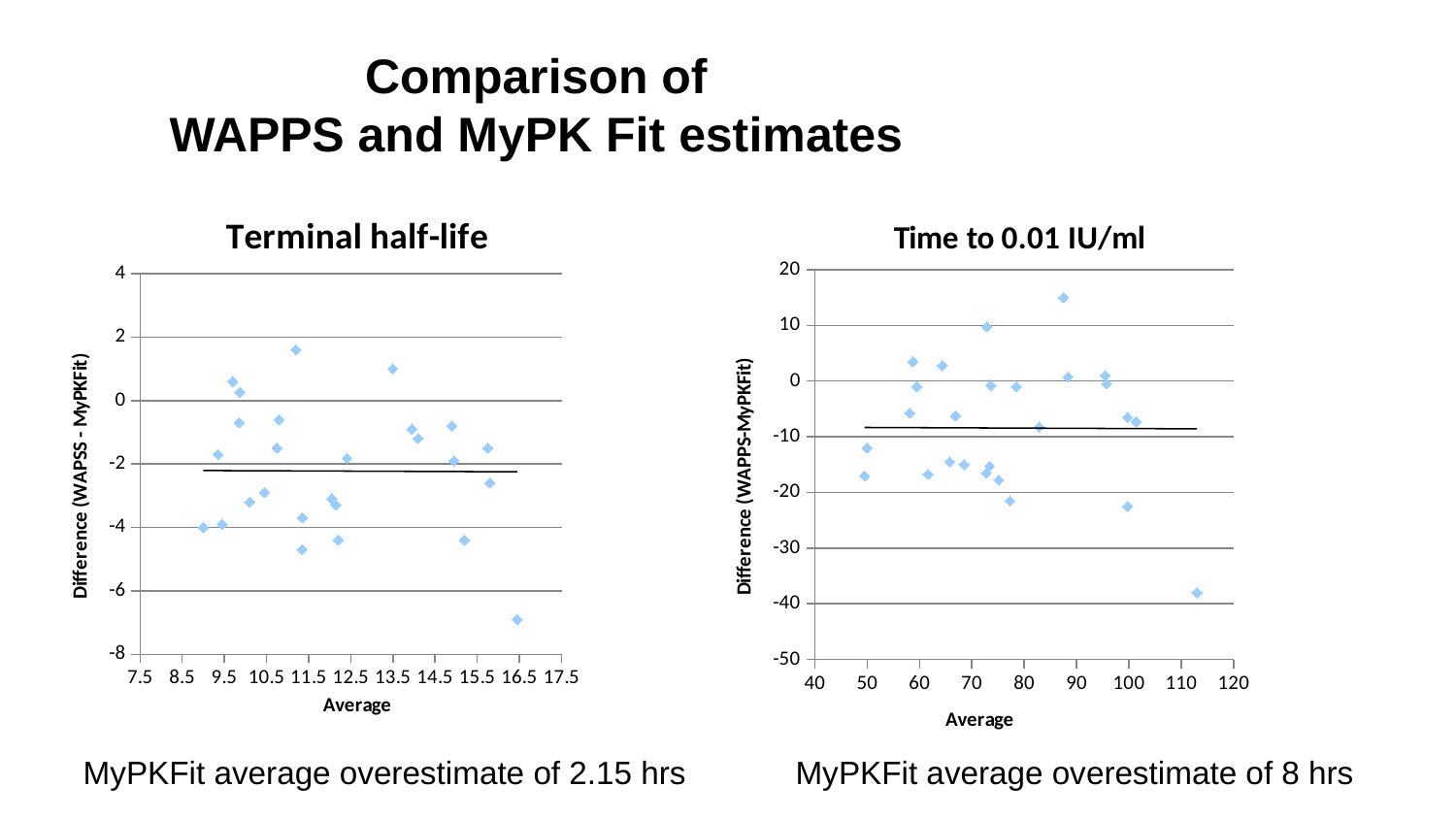
Which chart contains the lowest plotted difference value, Terminal half-life or Time to 0.01 IU/ml? Time to 0.01 IU/ml What kind of chart is the Time to 0.01 IU/ml chart? scatter chart What is the y-axis label of the Terminal half-life chart? Difference (WAPSS - MyPKFit) What is the x-axis label of the Time to 0.01 IU/ml chart? Average What kind of chart is the Terminal half-life chart? scatter chart In the Terminal half-life chart, is the highest plotted point greater or less than 2? less In the Time to 0.01 IU/ml chart, is the highest plotted point greater or less than 10? greater In the Time to 0.01 IU/ml chart, does the horizontal reference line lie above or below -10? above In the Time to 0.01 IU/ml chart, does the horizontal reference line rise, fall, or stay roughly flat across the x axis? roughly flat